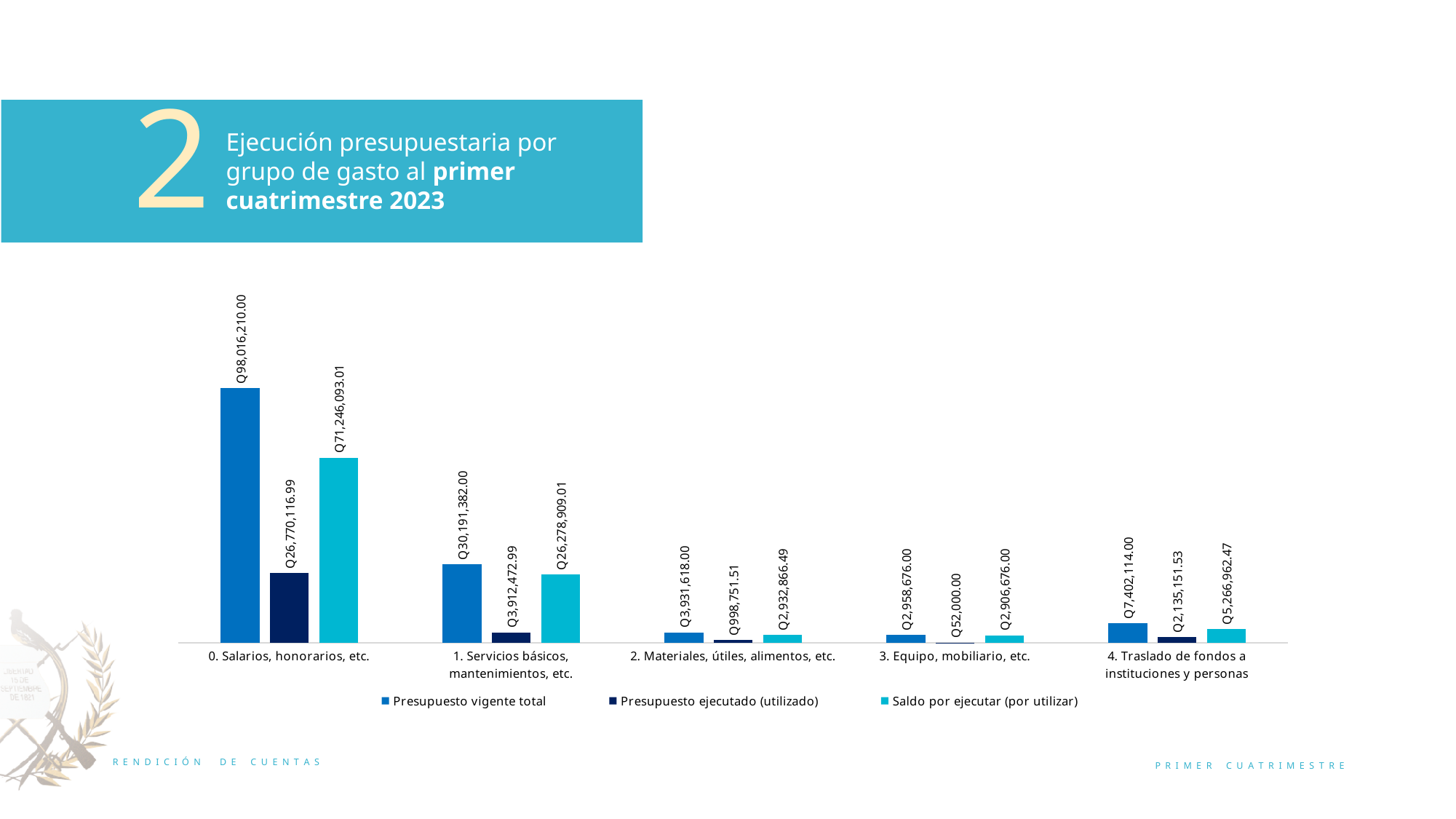
Which is larger: 'Presupuesto vigente total' for '2. Materiales, útiles, alimentos, etc.' or for '4. Traslado de fondos a instituciones y personas'? 4. Traslado de fondos a instituciones y personas Which category has the lowest 'Presupuesto ejecutado (utilizado)'? 3. Equipo, mobiliario, etc. How many series does the legend list? 3 What is the value of 'Presupuesto vigente total' for '0. Salarios, honorarios, etc.'? Q98,016,210.00 What is the title of the slide containing the chart? Ejecución presupuestaria por grupo de gasto al primer cuatrimestre 2023 How many expense group categories are shown on the x axis? 5 What is the value of 'Presupuesto ejecutado (utilizado)' for '3. Equipo, mobiliario, etc.'? Q52,000.00 Which category has the highest 'Presupuesto vigente total'? 0. Salarios, honorarios, etc. What is the difference between 'Presupuesto vigente total' and 'Presupuesto ejecutado (utilizado)' for '0. Salarios, honorarios, etc.'? Q71,246,093.01 What is the value of 'Presupuesto ejecutado (utilizado)' for '1. Servicios básicos, mantenimientos, etc.'? Q3,912,472.99 What type of chart is shown on the slide? Bar chart What is the value of 'Saldo por ejecutar (por utilizar)' for '4. Traslado de fondos a instituciones y personas'? Q5,266,962.47